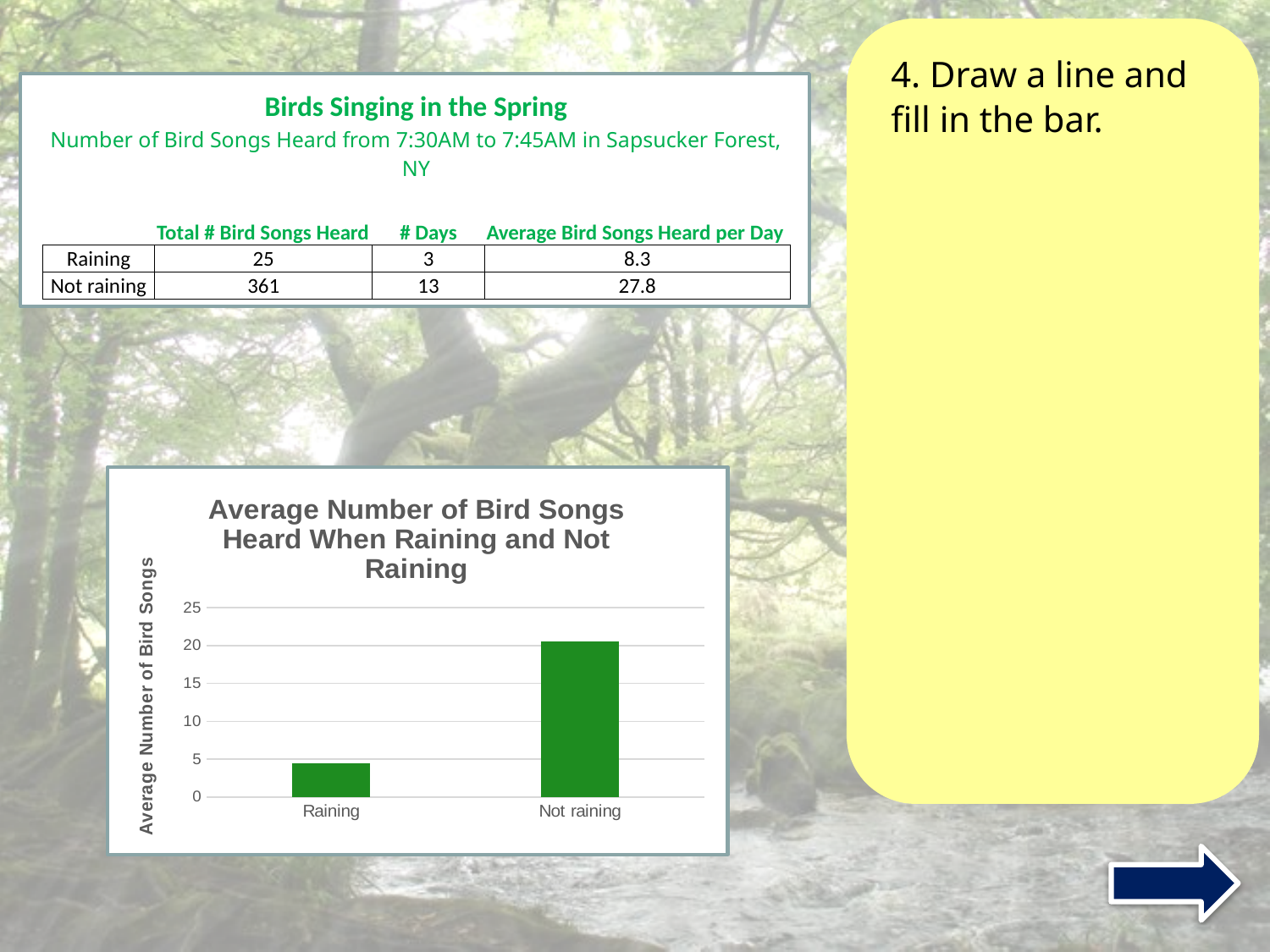
Is the value for Raining greater or less than 10? less Is the value for Raining greater or less than 5? less Which category has the lowest bar in the chart? Raining How many categories are plotted on the x axis of the chart? 2 What kind of chart is shown on the slide? bar chart Which category has the highest bar in the chart? Not raining Which bar is taller, Raining or Not raining? Not raining Is the value for Not raining greater or less than 25? less What is the title of the chart? Average Number of Bird Songs Heard When Raining and Not Raining What is the label on the y axis of the chart? Average Number of Bird Songs Do the bar values rise or fall moving from Raining to Not raining along the x axis? rise